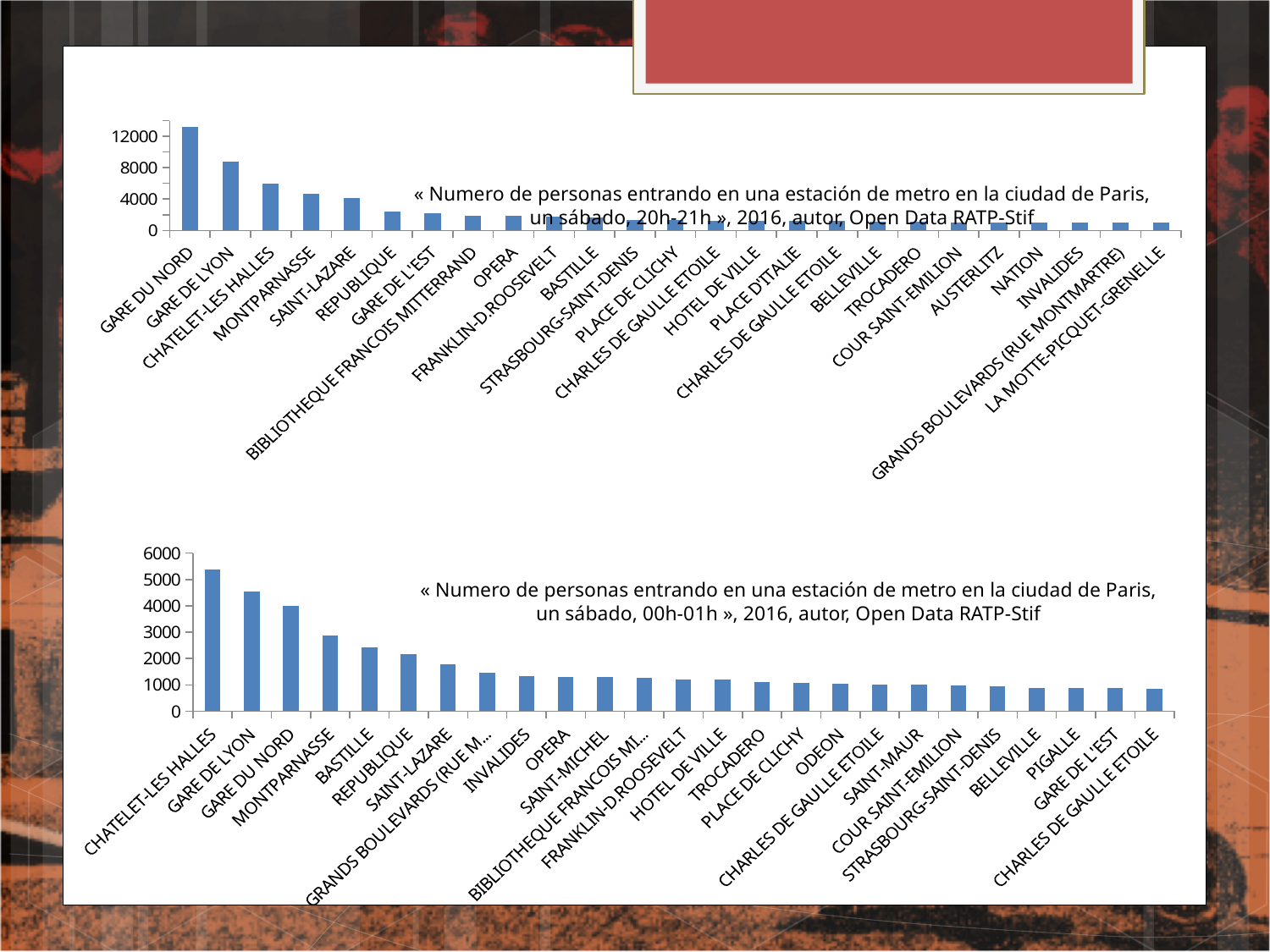
In the top chart (20h-21h), is the value for REPUBLIQUE greater or less than 4000? less In the bottom chart (00h-01h), which is larger, the value for GARE DE LYON or the value for GARE DU NORD? GARE DE LYON In the top chart (20h-21h), which is larger, the value for GARE DE LYON or the value for CHATELET-LES HALLES? GARE DE LYON In the top chart (20h-21h), is the value for GARE DU NORD greater or less than 12000? greater In the bottom chart (00h-01h), which station has the highest number of people entering? CHATELET-LES HALLES In the top chart (20h-21h), which station has the highest number of people entering? GARE DU NORD In the top chart (20h-21h), is the value for GARE DE LYON greater or less than 8000? greater How many stations are shown in the top chart (20h-21h)? 25 What kind of chart is the top chart (20h-21h)? bar chart In the bottom chart (00h-01h), do the values rise or fall from left to right along the x axis? fall